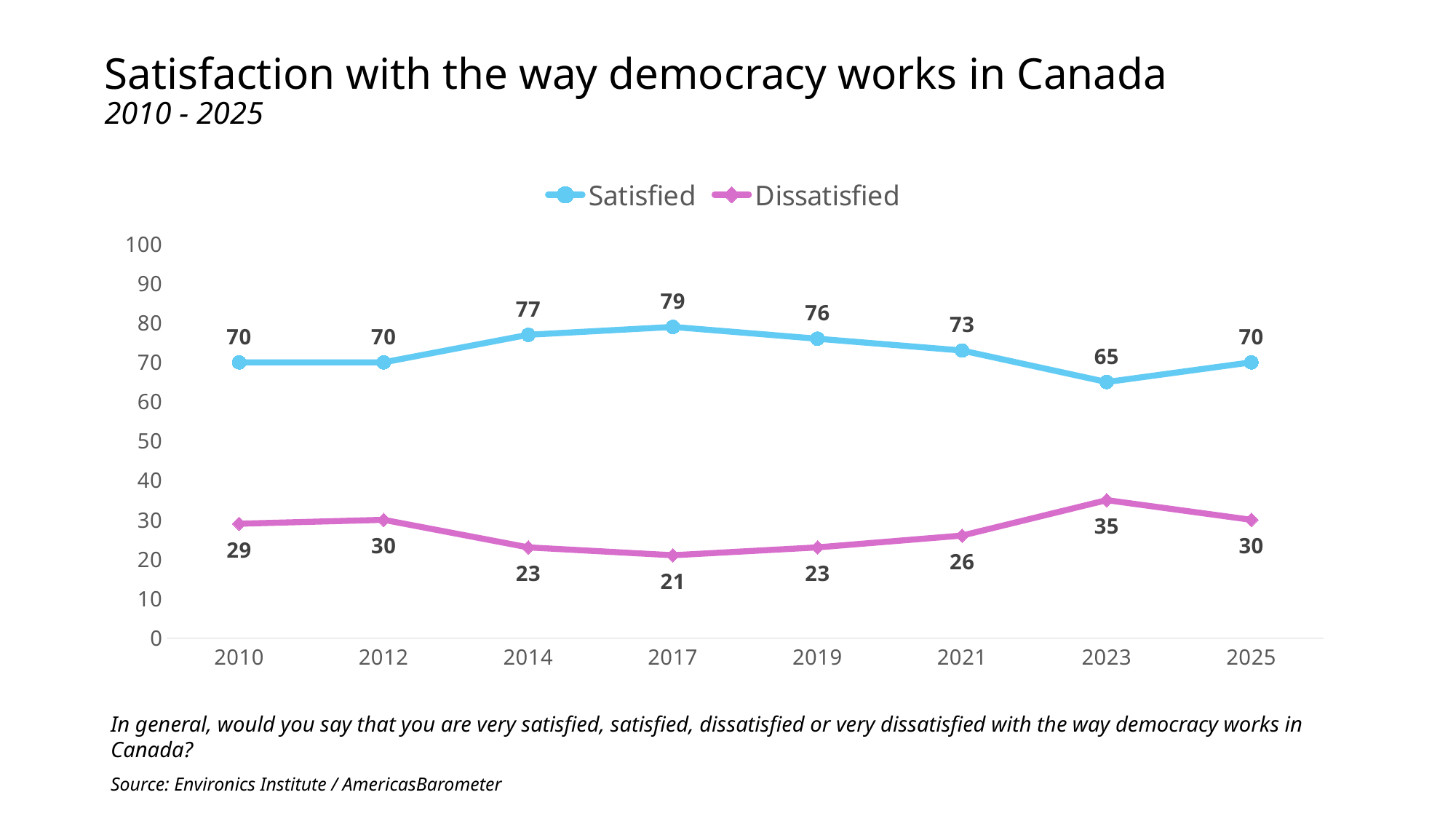
Which is larger: the Dissatisfied value in 2021 or in 2025? 2025 What is the title of the chart? Satisfaction with the way democracy works in Canada Does the Satisfied series rise or fall from 2017 to 2023? fall In which year is the Satisfied series highest? 2017 How many years are plotted on the x axis? 8 In which year is the Satisfied series lowest? 2023 In which year is the Dissatisfied series lowest? 2017 How many series does the legend list? 2 What is the difference between the Satisfied and Dissatisfied values in 2023? 30 What is the Satisfied value for 2017? 79 What kind of chart is shown on the slide? line chart What is the Dissatisfied value for 2023? 35